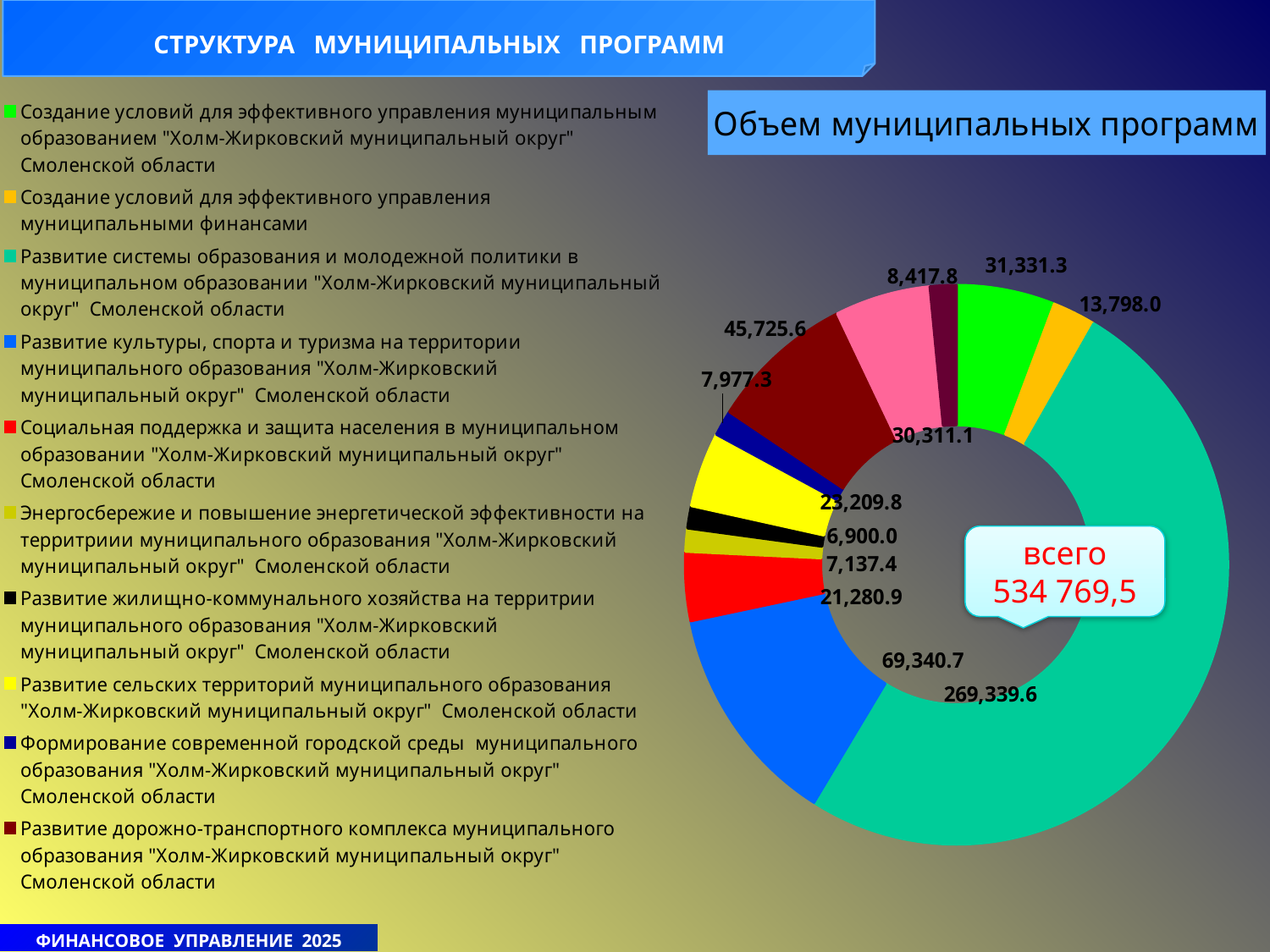
What is the title of the doughnut chart on the slide? Объем муниципальных программ How many programmes does the legend list? 10 What kind of chart is shown on the slide? Doughnut (pie) chart What is the value for "Развитие дорожно-транспортного комплекса" (the dark red slice)? 45,725.6 What is the value for "Социальная поддержка и защита населения" (the red slice)? 21,280.9 What is the smallest value labelled on the chart? 6,900.0 What is the value for "Развитие системы образования и молодежной политики" (the teal slice)? 269,339.6 Which programme has the largest share of the chart? Развитие системы образования и молодежной политики What is the value for "Развитие культуры, спорта и туризма" (the blue slice)? 69,340.7 What is the difference between the values for "Развитие системы образования" (269,339.6) and "Развитие культуры, спорта и туризма" (69,340.7)? 199,998.9 What is the value for "Создание условий для эффективного управления муниципальным образованием" (the green slice)? 31,331.3 What is the value for "Создание условий для эффективного управления муниципальными финансами" (the orange slice)? 13,798.0